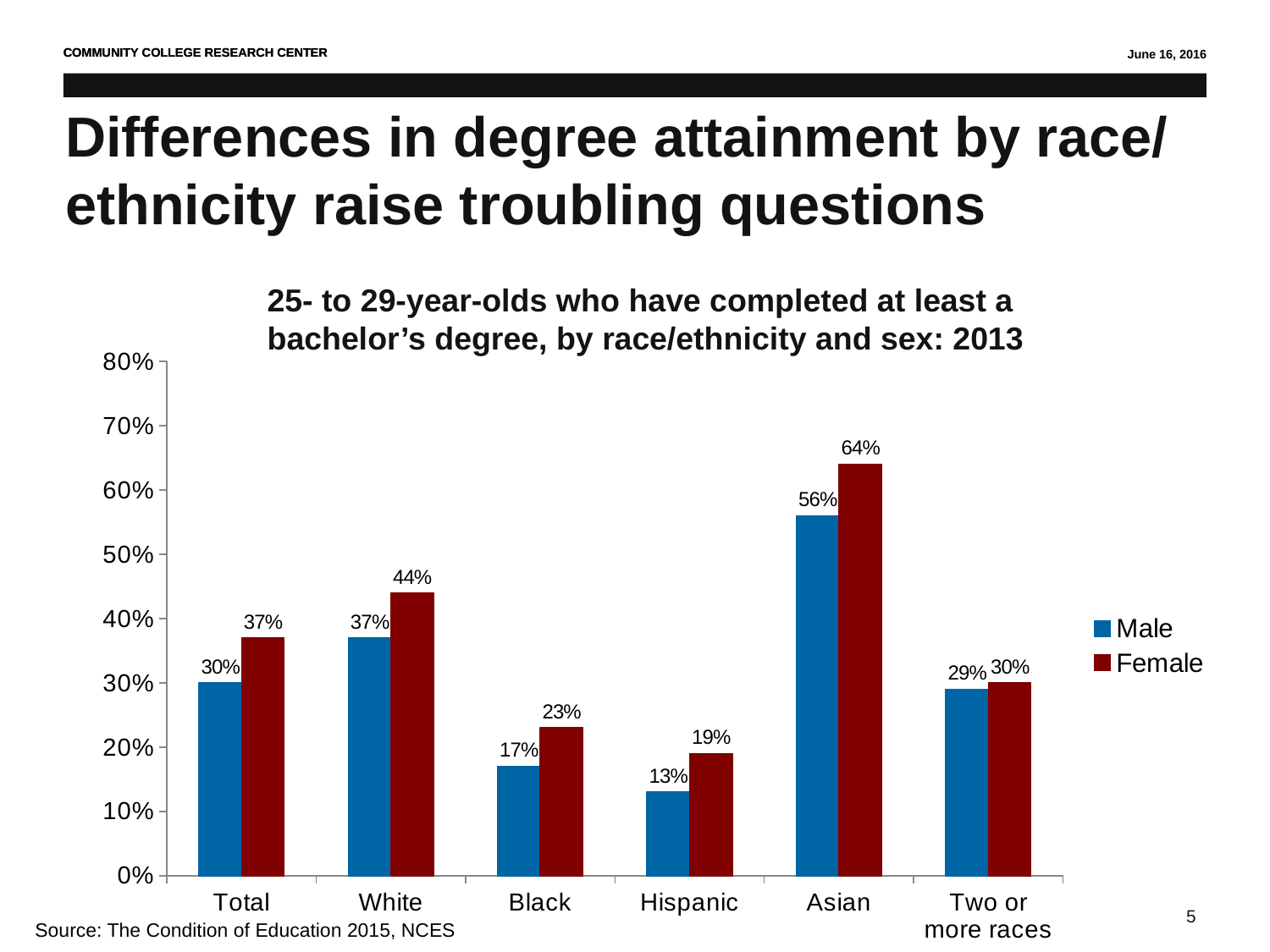
What is the Female value for Asian? 64% Is the Female value for Asian greater or less than 60%? greater What is the difference between the Female and Male values for White? 7% What is the Male value for Hispanic? 13% How many series does the legend list? 2 Which category has the highest Male value? Asian What kind of chart is shown on the slide? bar chart What is the Male value for Two or more races? 29% Which category has the lowest Female value? Hispanic Which is larger, the Male value for Black or the Male value for Hispanic? Black What colour represents the Female series? dark red How many categories are shown on the x axis? 6